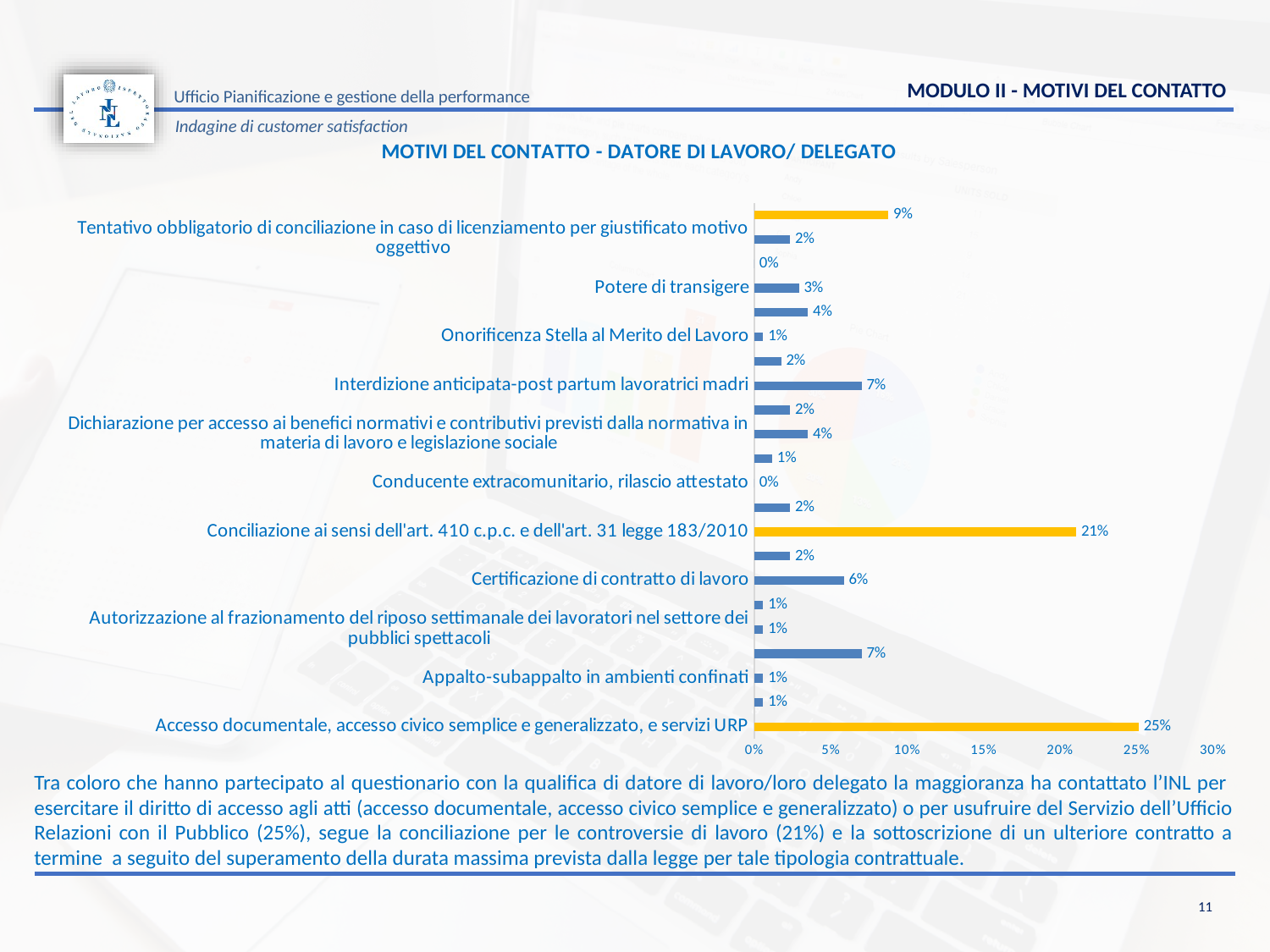
What is the value for 'Conciliazione ai sensi dell'art. 410 c.p.c. e dell'art. 31 legge 183/2010'? 21% Which is larger: the value for 'Interdizione anticipata-post partum lavoratrici madri' or for 'Certificazione di contratto di lavoro'? Interdizione anticipata-post partum lavoratrici madri Which category has the highest value in the chart? Accesso documentale, accesso civico semplice e generalizzato, e servizi URP What is the title of the chart? MOTIVI DEL CONTATTO - DATORE DI LAVORO/ DELEGATO What is the value for 'Accesso documentale, accesso civico semplice e generalizzato, e servizi URP'? 25% Is the value for 'Conciliazione ai sensi dell'art. 410 c.p.c. e dell'art. 31 legge 183/2010' greater or less than 20%? greater What kind of chart is shown on the slide? bar chart What is the value for 'Certificazione di contratto di lavoro'? 6% What is the value for 'Conducente extracomunitario, rilascio attestato'? 0% What is the difference between the values for 'Accesso documentale, accesso civico semplice e generalizzato, e servizi URP' and 'Conciliazione ai sensi dell'art. 410 c.p.c. e dell'art. 31 legge 183/2010'? 4% What is the value for 'Potere di transigere'? 3% What is the value for 'Interdizione anticipata-post partum lavoratrici madri'? 7%